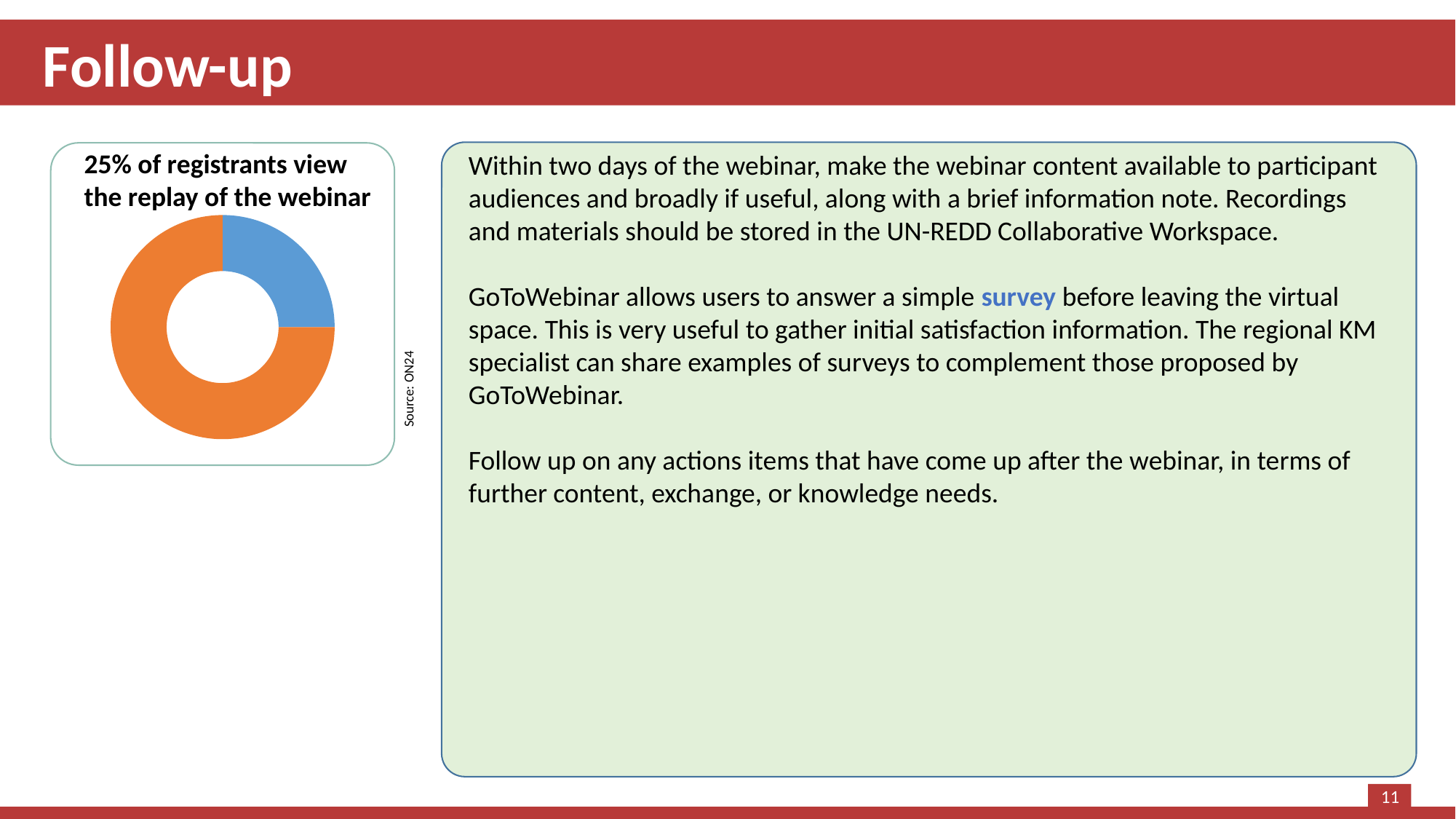
What kind of chart is shown on the slide? doughnut chart How many slices does the doughnut chart have? 2 What share of the doughnut chart does the orange slice represent? 75% Is the blue slice or the orange slice larger in the doughnut chart? the orange slice What source is cited for the doughnut chart? ON24 What share of the doughnut chart does the blue slice represent? 25% Which slice of the doughnut chart is the smallest? the blue slice Which slice of the doughnut chart is the largest? the orange slice What is the title of the doughnut chart? 25% of registrants view the replay of the webinar